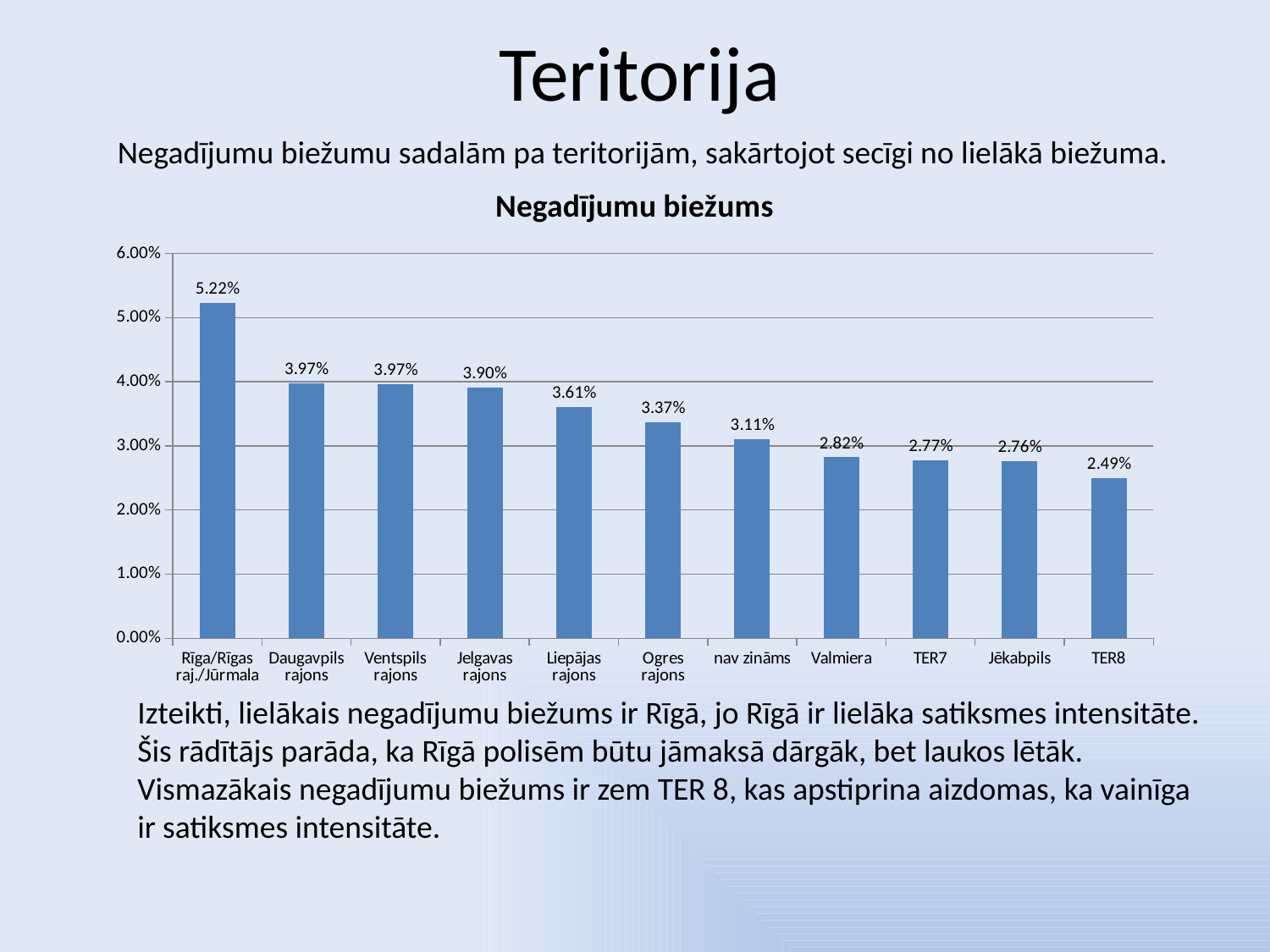
How many categories are shown on the x axis? 11 Is the value for nav zināms greater or less than 3.00%? greater What is the difference between the values for Ogres rajons and nav zināms? 0.26% What is the difference between the values for Rīga/Rīgas raj./Jūrmala and TER8? 2.73% Which category has the highest value? Rīga/Rīgas raj./Jūrmala What is the value for Rīga/Rīgas raj./Jūrmala? 5.22% Which category has the lowest value? TER8 What is the value for TER8? 2.49% What is the title of the chart? Negadījumu biežums What kind of chart is shown? bar chart Which is larger, the value for Jelgavas rajons or the value for Valmiera? Jelgavas rajons What is the value for Liepājas rajons? 3.61%